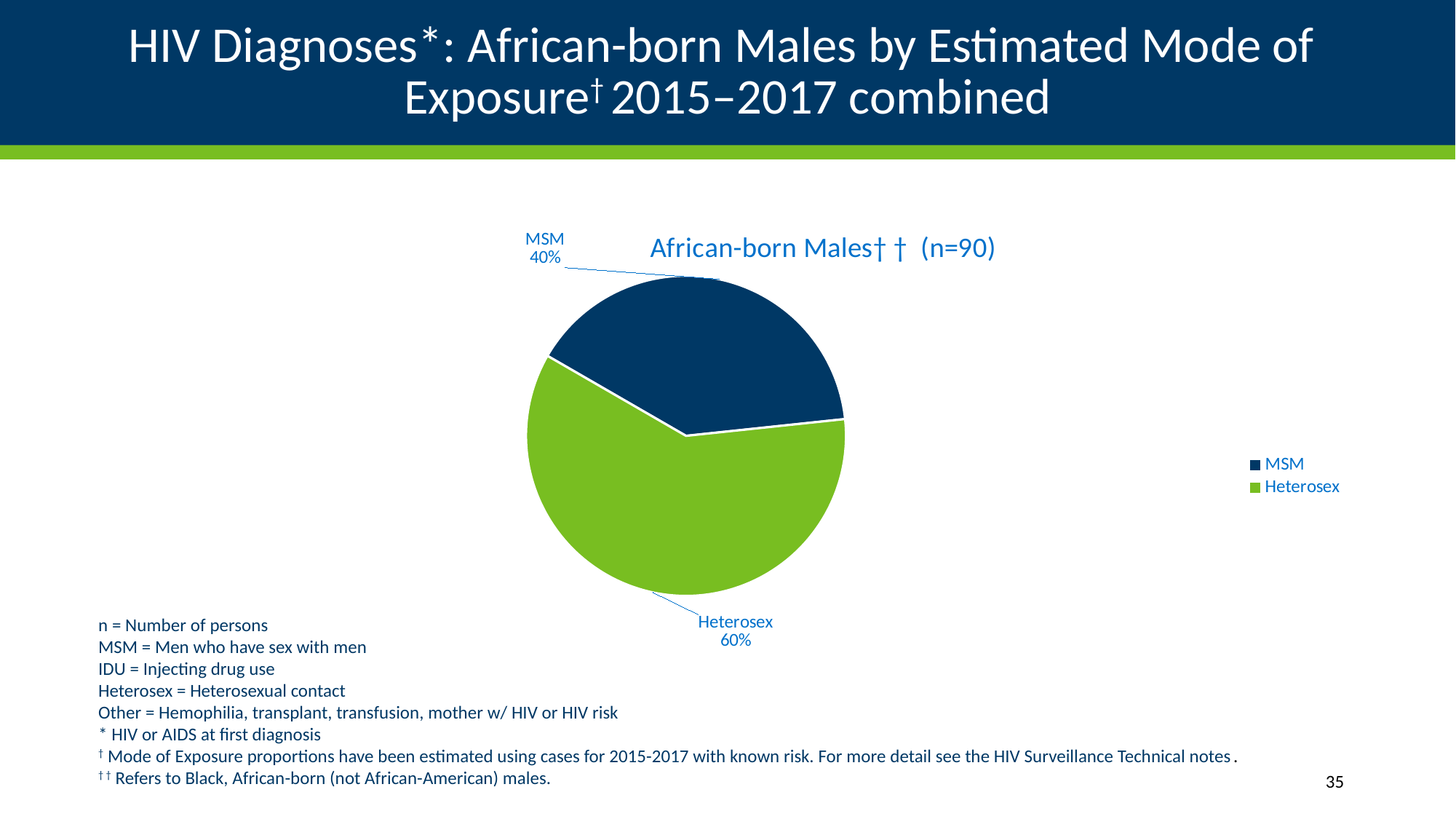
What is the chart's title? African-born Males† † (n=90) How many entries does the legend list? 2 Which mode of exposure has the smallest share of the pie? MSM Which slice is larger, MSM or Heterosex? Heterosex How many slices does the pie chart have? 2 What is the value of n shown in the chart title? 90 Which mode of exposure has the largest share of the pie? Heterosex What is the difference in percentage points between the Heterosex and MSM slices? 20 What percentage of the pie is Heterosex? 60% What type of chart is shown on the slide? pie chart What percentage of the pie is MSM? 40% What colour is the Heterosex slice? green